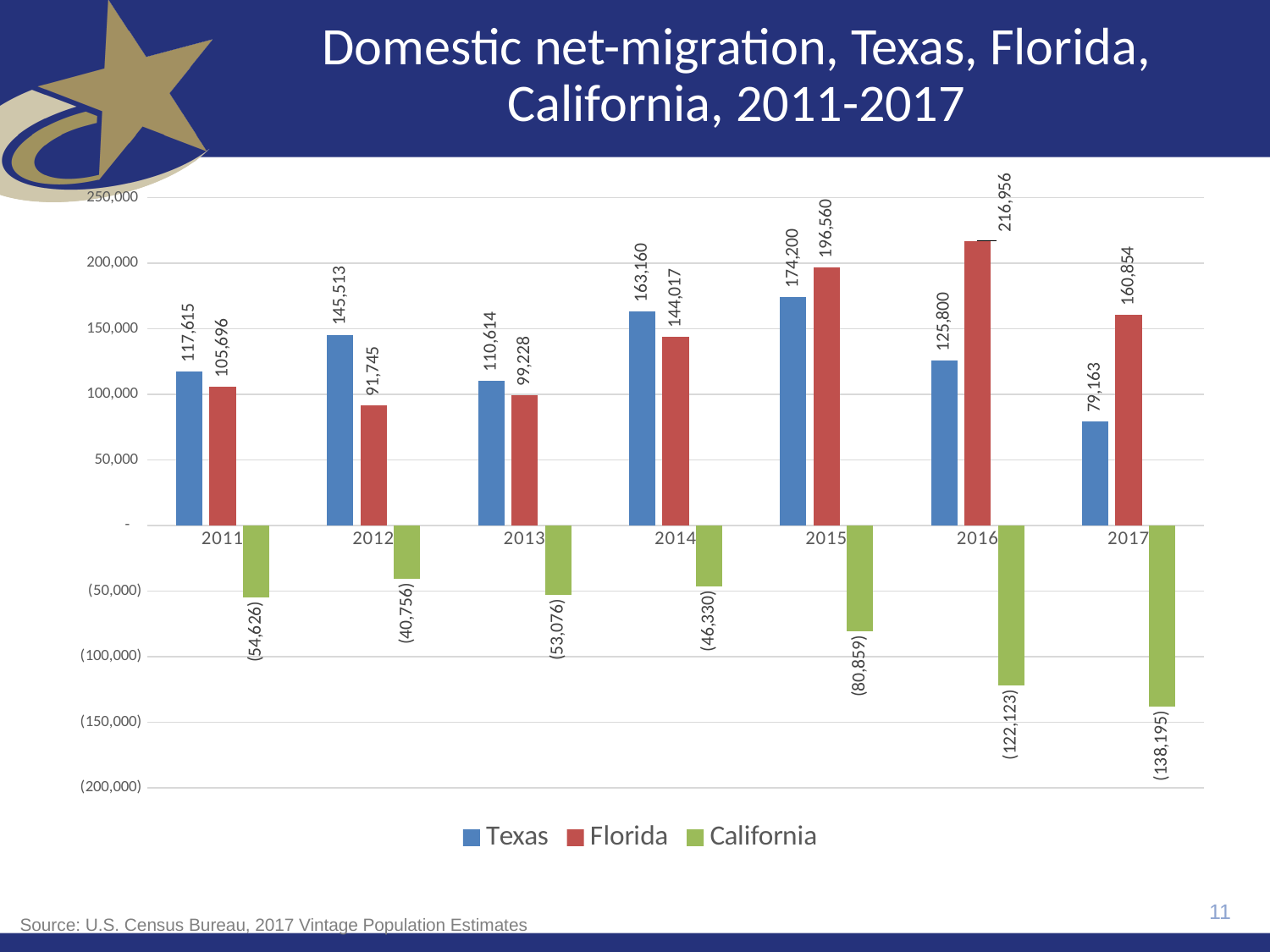
What is the domestic net-migration value for Florida in 2012? 91,745 How many series does the legend list? 3 What is the domestic net-migration value for Texas in 2015? 174,200 In which year is the Florida value highest? 2016 How many years are shown on the x axis? 7 What kind of chart is shown on the slide? Bar chart What is the difference between the Florida and Texas values in 2017? 81,691 Which colour represents California in the chart? Green In which year is the Texas value lowest? 2017 What is the domestic net-migration value for California in 2017? (138,195) Which is larger in 2013, the Texas value or the Florida value? Texas Does the California value become more negative or less negative from 2014 to 2017? More negative